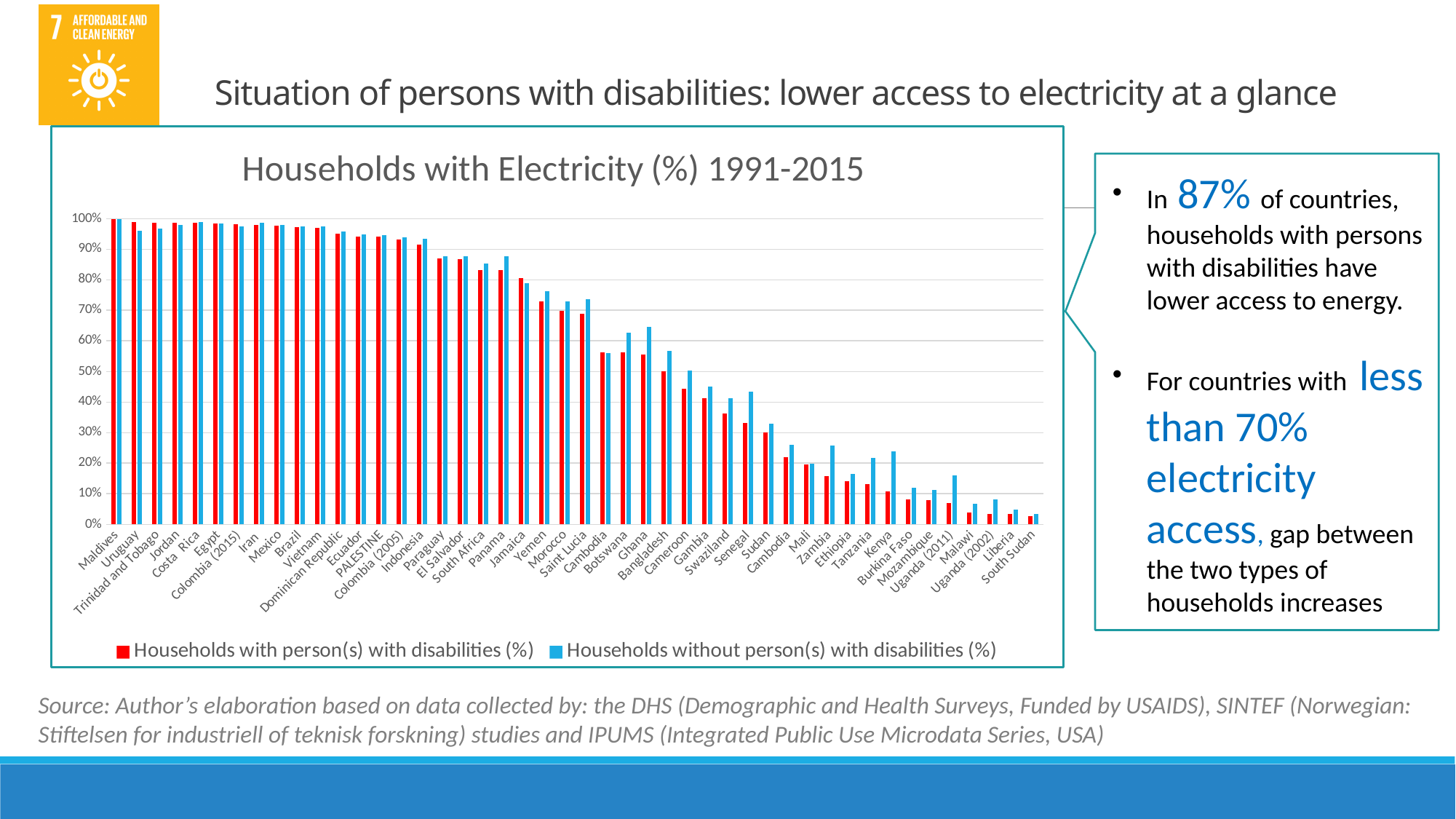
Is the value for households with person(s) with disabilities in Ghana greater or less than 50%? greater Which country has the highest share of households with electricity? Maldives Which colour represents households with person(s) with disabilities in the chart? red Which country has the lowest share of households with electricity? South Sudan Is the value for households without person(s) with disabilities in Botswana greater or less than 60%? greater Is the value for households without person(s) with disabilities in Kenya greater or less than 20%? greater How many series does the legend list? 2 What is the title of the chart? Households with Electricity (%) 1991-2015 What kind of chart is shown on the slide? bar chart Which has a higher share of households with person(s) with disabilities with electricity, Ghana or Kenya? Ghana Do the values generally rise or fall moving from left to right along the x axis? fall